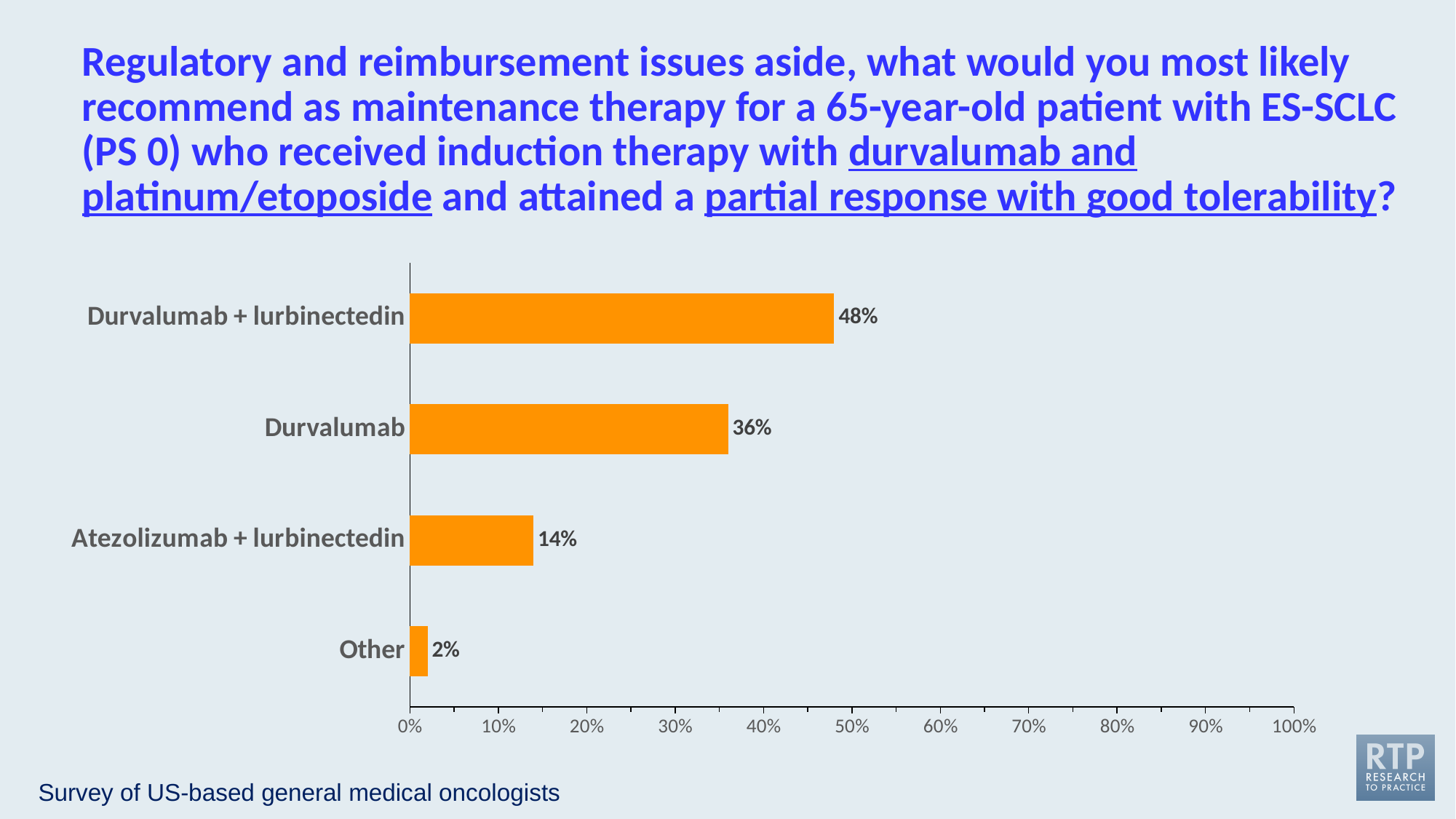
What percentage of respondents chose Durvalumab + lurbinectedin? 48% Which received a larger share of responses, Durvalumab or Atezolizumab + lurbinectedin? Durvalumab What is the difference in percentage points between Durvalumab and Atezolizumab + lurbinectedin? 22 What is the difference in percentage points between Durvalumab + lurbinectedin and Durvalumab? 12 How many response options are shown in the chart? 4 What percentage of respondents chose Other? 2% Is the value for Durvalumab + lurbinectedin greater or less than 50%? less What percentage of respondents chose Durvalumab alone? 36% What percentage of respondents chose Atezolizumab + lurbinectedin? 14% What type of chart is shown on the slide? Bar chart Which option received the highest percentage of responses? Durvalumab + lurbinectedin Which option received the lowest percentage of responses? Other